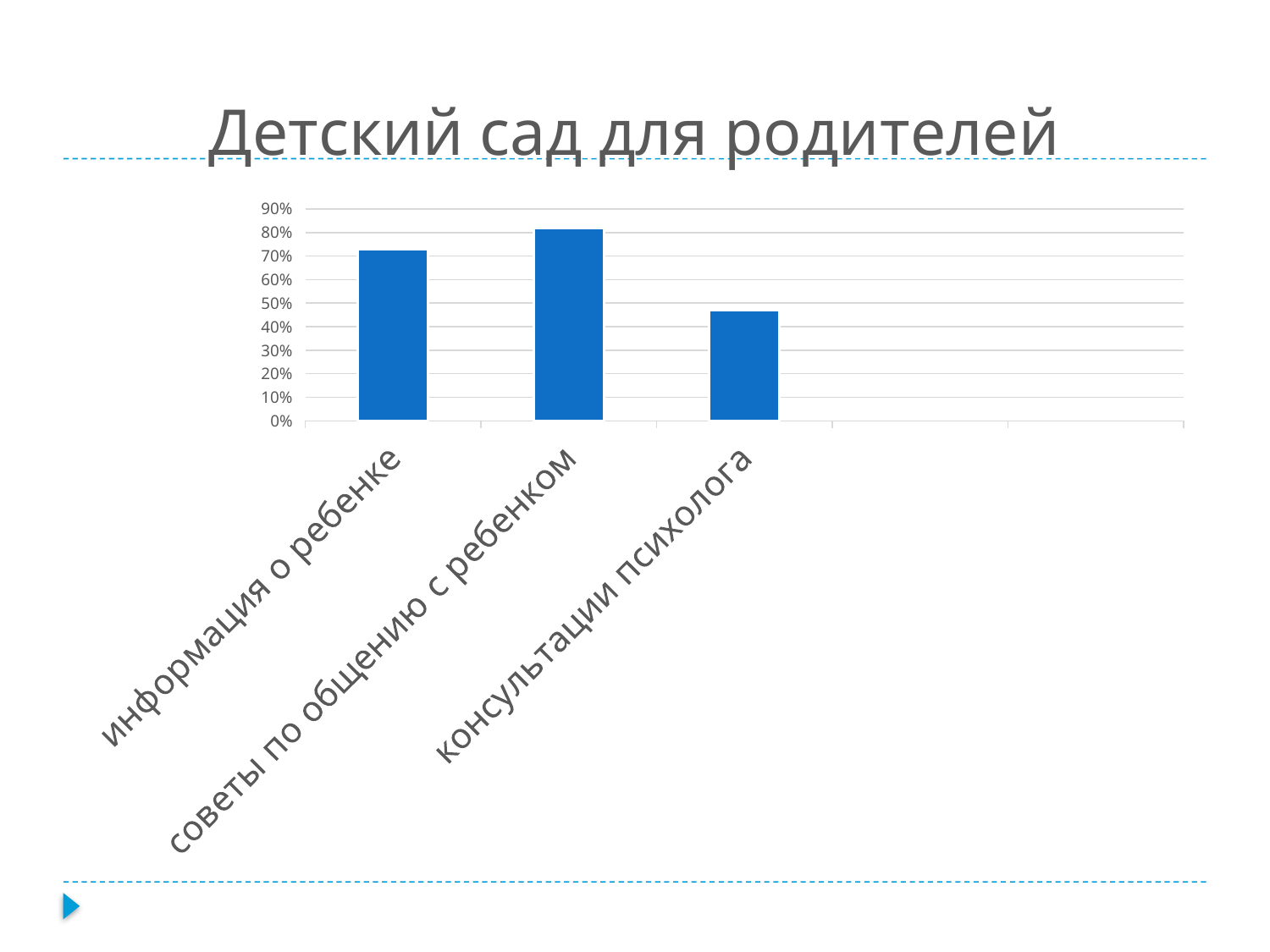
Which category has the lowest value? консультации психолога Which is larger, the value for советы по общению с ребенком or the value for информация о ребенке? советы по общению с ребенком What is the title of the slide containing the chart? Детский сад для родителей Is the value for консультации психолога greater or less than 60%? less Which category has the highest value? советы по общению с ребенком How many categories are plotted in the chart? 3 Is the value for информация о ребенке greater or less than 80%? less What kind of chart is shown on the slide? bar chart Which is larger, the value for информация о ребенке or the value for консультации психолога? информация о ребенке Is the value for советы по общению с ребенком greater or less than 70%? greater